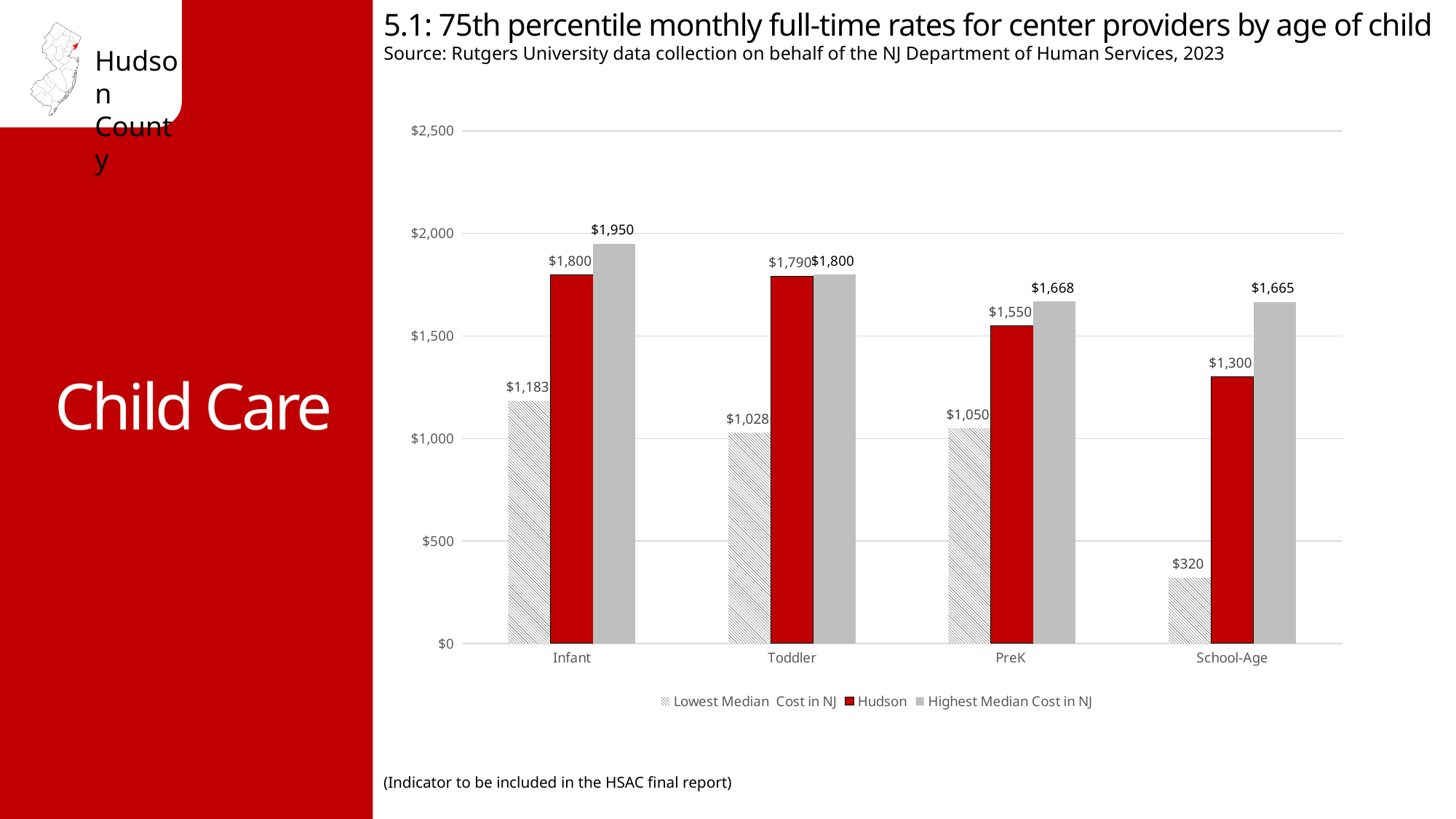
Is the Hudson value for PreK greater or less than $1,500? greater What is the difference between the Highest Median Cost in NJ and the Hudson value for Infant? $150 How many age groups are shown on the x axis? 4 Which age group has the lowest Lowest Median Cost in NJ value? School-Age What is the Hudson value for Infant? $1,800 What is the Lowest Median Cost in NJ for School-Age? $320 Which age group has the highest Hudson value? Infant How many series does the legend list? 3 Which is larger for Toddler: the Hudson value or the Lowest Median Cost in NJ? Hudson What kind of chart is shown on the slide? Bar chart What is the Highest Median Cost in NJ for PreK? $1,668 What is the difference between the Hudson value and the Lowest Median Cost in NJ for School-Age? $980